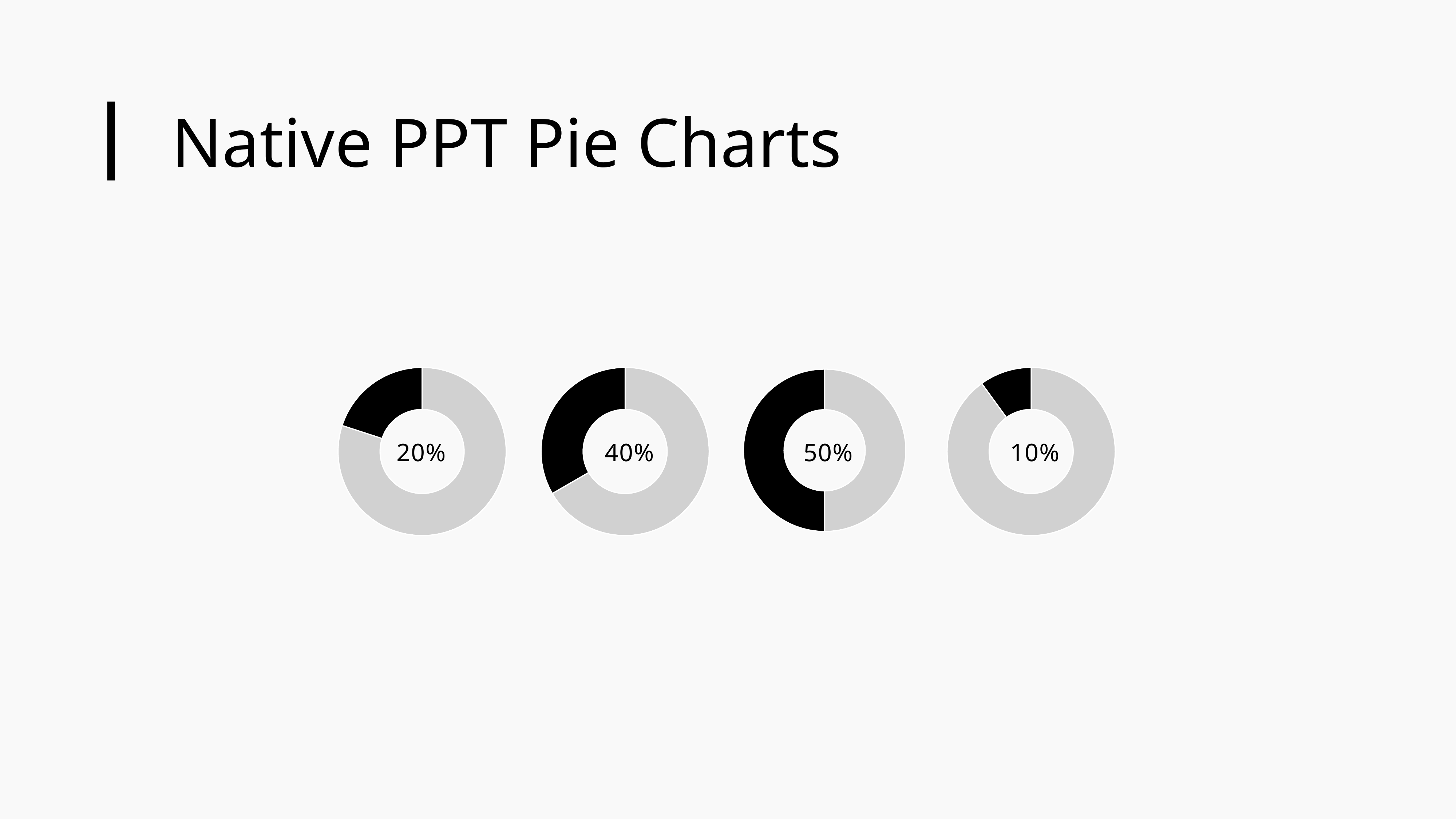
What percentage is shown in the centre of the leftmost doughnut chart? 20% What kind of chart is used on this slide? Doughnut (pie) chart What is the difference between the percentage in the third doughnut chart and the percentage in the leftmost doughnut chart? 30% How many doughnut charts are shown on the slide? 4 What percentage is shown in the centre of the rightmost doughnut chart? 10% What percentage is shown in the centre of the third doughnut chart from the left? 50% In the third doughnut chart from the left, what share of the ring is filled black? 50% Which doughnut chart shows the highest percentage? The third from the left (50%) Which doughnut chart shows the lowest percentage? The rightmost (10%) What percentage is shown in the centre of the second doughnut chart from the left? 40% Which is larger: the percentage in the second doughnut chart from the left or the percentage in the rightmost doughnut chart? The second from the left (40%) What is the title of the slide? Native PPT Pie Charts